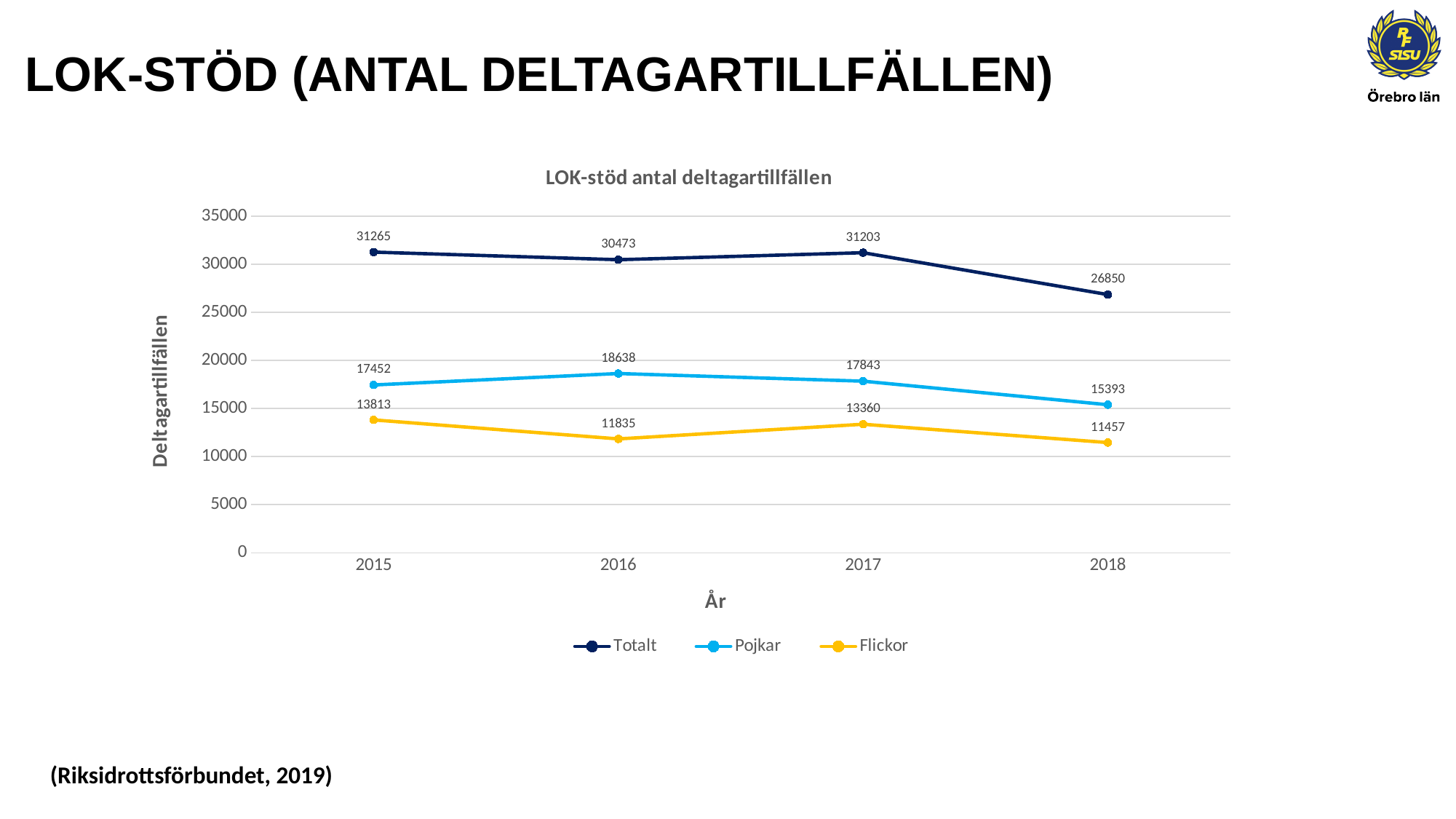
Which is larger, the Flickor value in 2015 or in 2017? 2015 What kind of chart is shown? line chart How many years are shown on the x axis? 4 Is the value for Pojkar in 2018 greater or less than 15000? greater In which year is the Pojkar value highest? 2016 How many series does the legend list? 3 What is the value for Flickor in 2018? 11457 In which year is the Totalt value lowest? 2018 What is the value for Pojkar in 2016? 18638 What is the difference between the Totalt values for 2017 and 2018? 4353 What is the title of the chart? LOK-stöd antal deltagartillfällen What is the value for Totalt in 2015? 31265